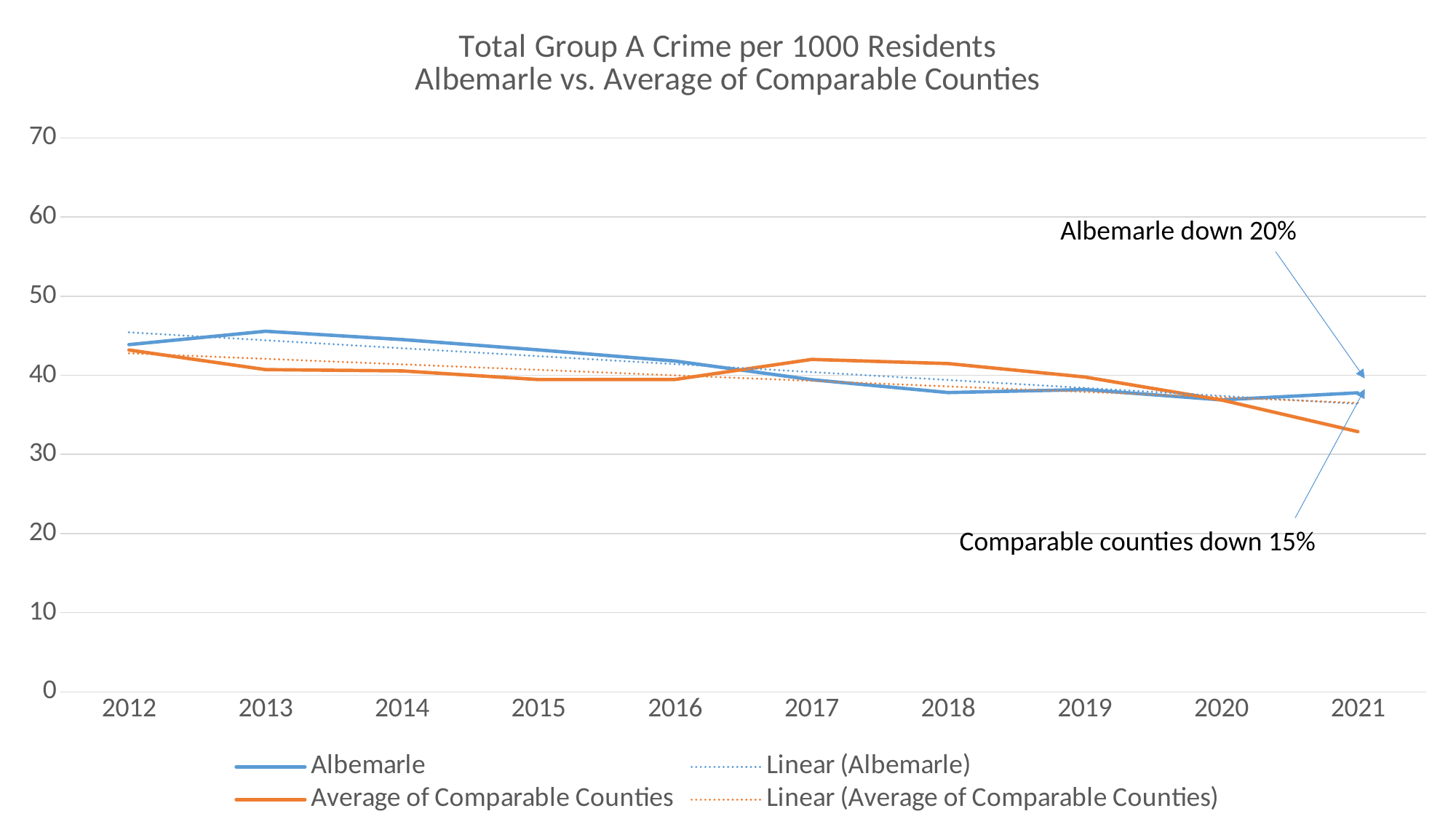
In which year does the Albemarle line reach its highest value? 2013 Is the Albemarle value for 2013 greater or less than 50? less What kind of chart is shown on the slide? line chart How many years are shown along the x axis? 10 According to the annotation on the chart, by what percentage is Albemarle down? 20% In 2017, which series has the higher value, Albemarle or Average of Comparable Counties? Average of Comparable Counties Is the Albemarle value for 2012 greater or less than 40? greater In 2021, which series has the higher value, Albemarle or Average of Comparable Counties? Albemarle Does the Albemarle line generally rise or fall from 2012 to 2021? fall Is the Average of Comparable Counties value for 2021 greater or less than 40? less How many entries does the legend list? 4 In which year does the Average of Comparable Counties line reach its lowest value? 2021